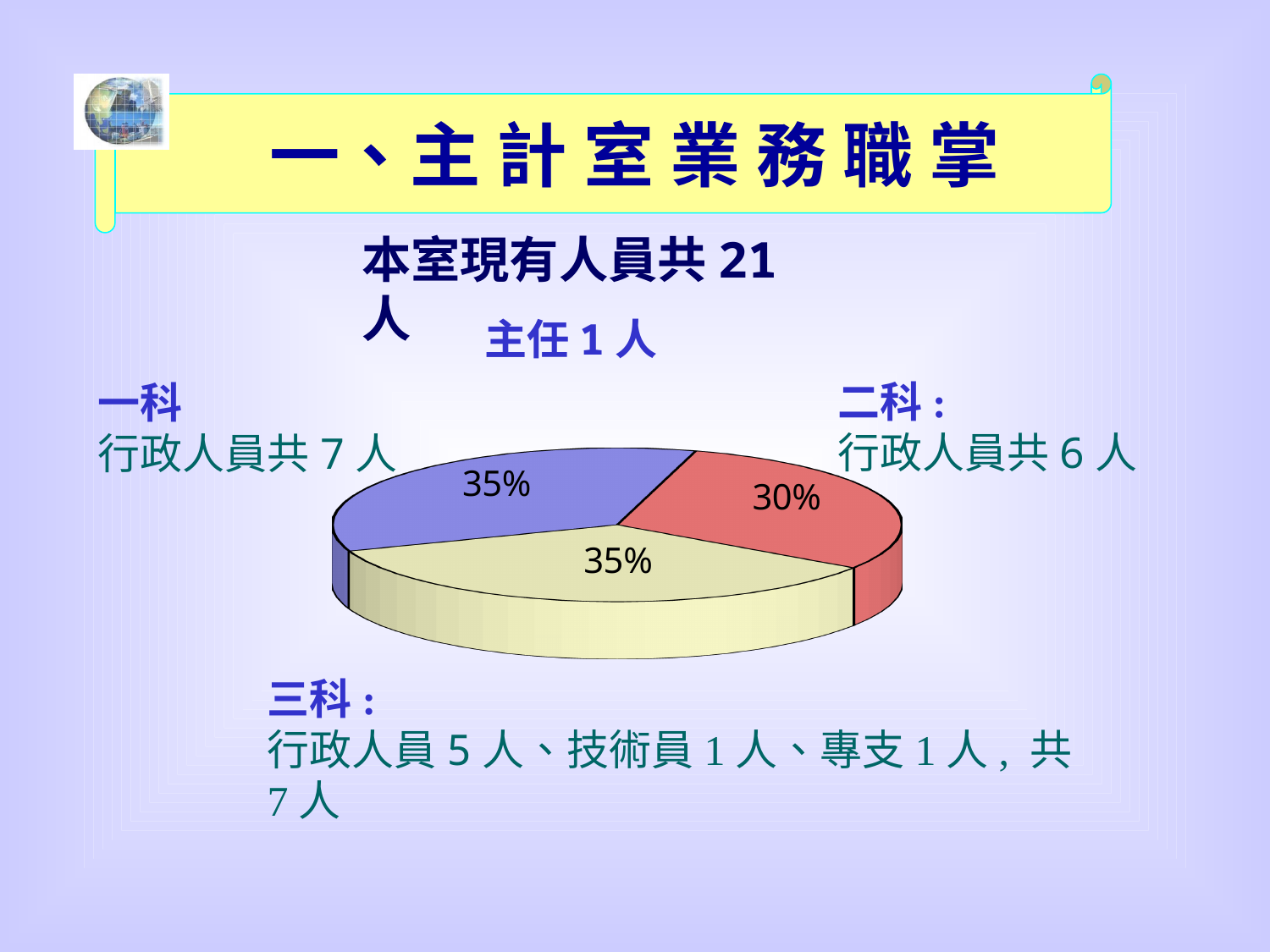
How many administrative staff does 二科 have according to the label next to the pie chart? 6 人 How many slices does the pie chart have? 3 Is the value of the red slice greater or less than 35%? less Which is larger, the yellow slice or the red slice? yellow slice What percentage is shown on the blue slice of the pie chart? 35% What percentage is shown on the red slice of the pie chart? 30% Which colour slice of the pie chart is the smallest? red What is the difference between the blue slice's percentage and the red slice's percentage? 5% What is the total number of staff stated above the pie chart (本室現有人員共)? 21 人 What percentage is shown on the yellow slice of the pie chart? 35% What kind of chart is shown on the slide? pie chart Do the blue and yellow slices show the same percentage? yes